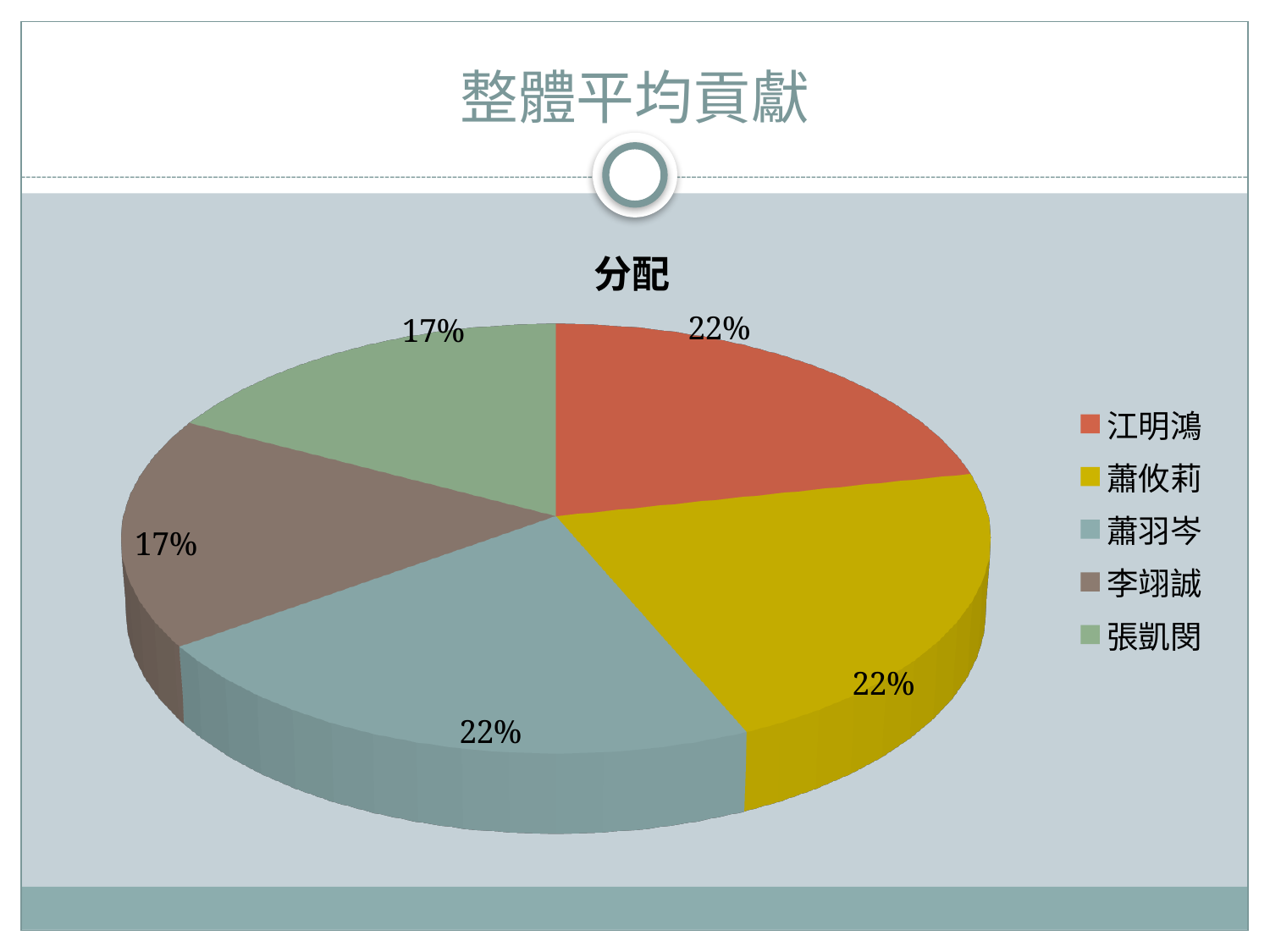
What share of the pie does 江明鴻 have? 22% What share of the pie does 蕭羽岑 have? 22% Which colour represents 蕭羽岑 in the legend? teal (blue-grey) What share of the pie does 張凱閔 have? 17% What is the difference between the share for 蕭攸莉 and the share for 張凱閔? 5% What kind of chart is shown on the slide? pie chart Which is larger, the share for 江明鴻 or the share for 李翊誠? 江明鴻 How many entries does the legend list? 5 What is the title of the chart? 分配 How many slices does the pie chart have? 5